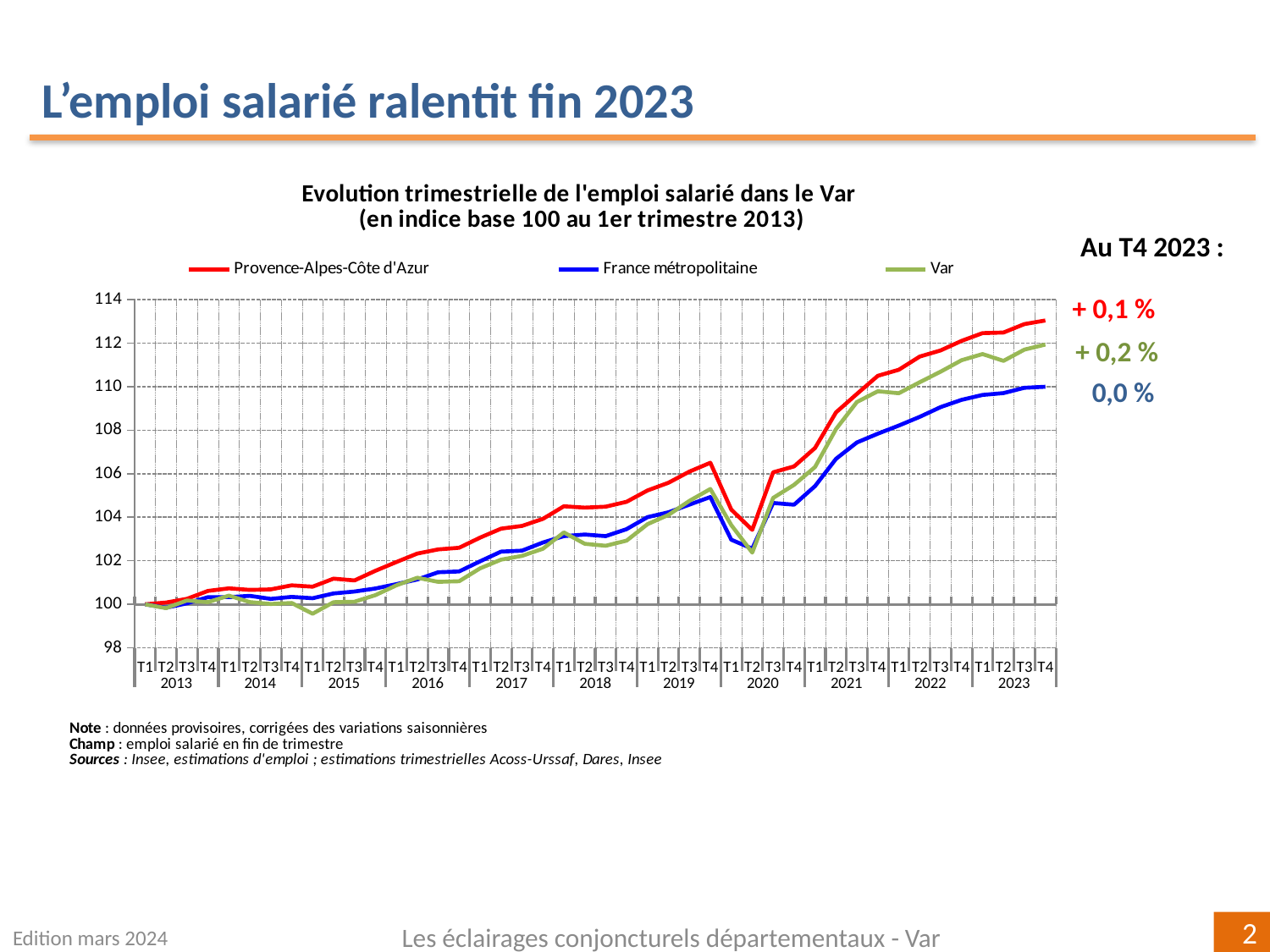
According to the annotation, what is the change for Var at T4 2023? + 0,2 % How many series does the legend list? 3 Is the value for Provence-Alpes-Côte d'Azur at T4 2023 greater or less than 112? greater According to the annotation, what is the change for France métropolitaine at T4 2023? 0,0 % Which series is drawn in red? Provence-Alpes-Côte d'Azur What is the base value of the index at the 1st quarter of 2013? 100 Which series has the highest index value at T4 2023? Provence-Alpes-Côte d'Azur How many years are shown on the x axis? 11 Overall, do the index values rise or fall from 2013 to 2023? rise Which series has the lowest index value at T4 2023? France métropolitaine Is the value for Var at T2 2020 greater or less than 104? less What kind of chart is shown on the slide? line chart